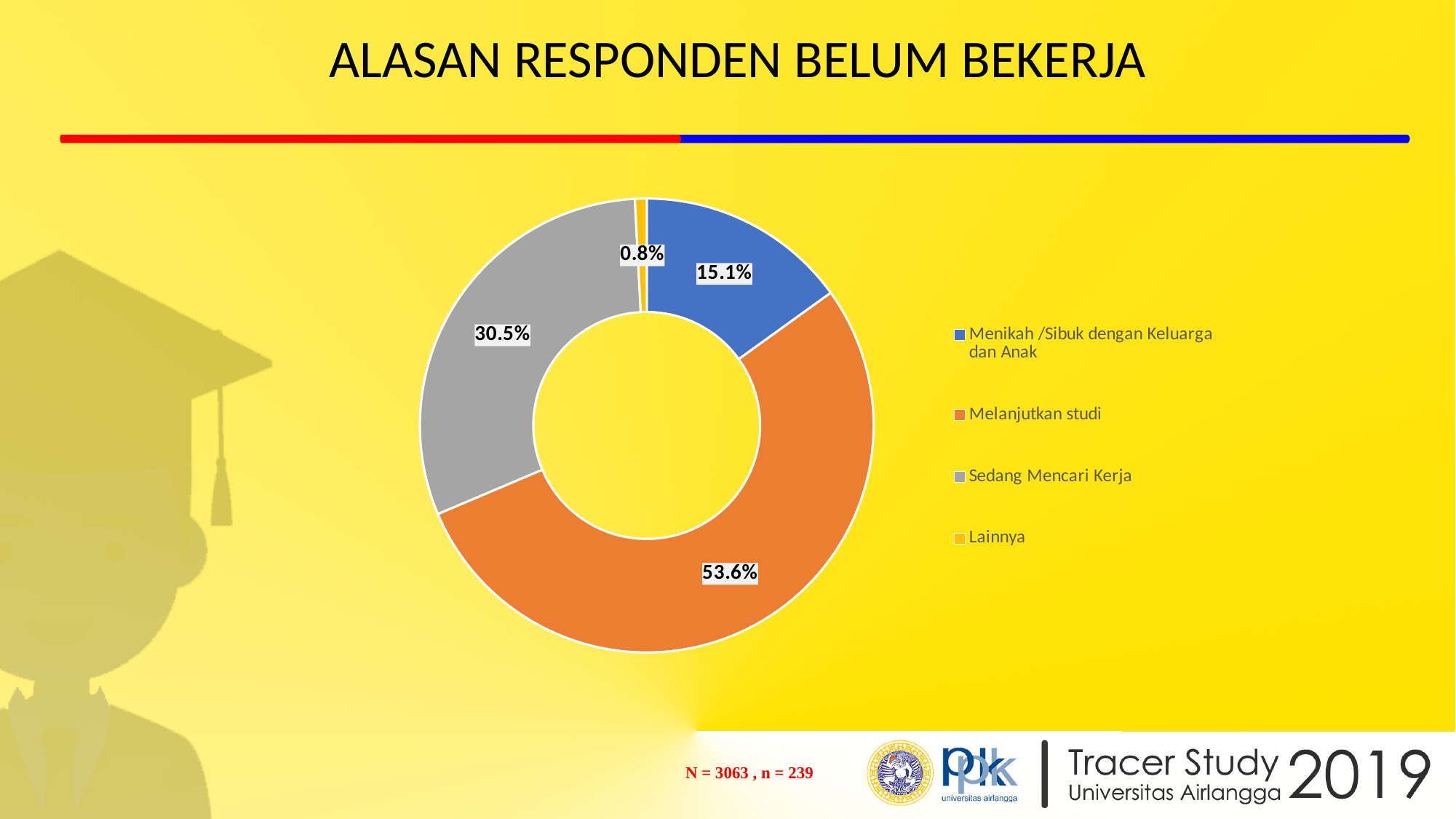
What percentage of respondents are "Sedang Mencari Kerja"? 30.5% Which category has the smallest share of the chart? Lainnya What kind of chart is shown on the slide? Doughnut (pie) chart What is the title of the slide? ALASAN RESPONDEN BELUM BEKERJA What is the difference in percentage points between "Melanjutkan studi" and "Sedang Mencari Kerja"? 23.1 How many categories does the chart show? 4 Which is larger: "Sedang Mencari Kerja" or "Menikah /Sibuk dengan Keluarga dan Anak"? Sedang Mencari Kerja What percentage of respondents gave "Melanjutkan studi" as their reason for not yet working? 53.6% Which category has the largest share of the chart? Melanjutkan studi What is the value for "Menikah /Sibuk dengan Keluarga dan Anak"? 15.1% What is the value for "Lainnya"? 0.8% Which colour represents "Sedang Mencari Kerja" in the chart? Grey